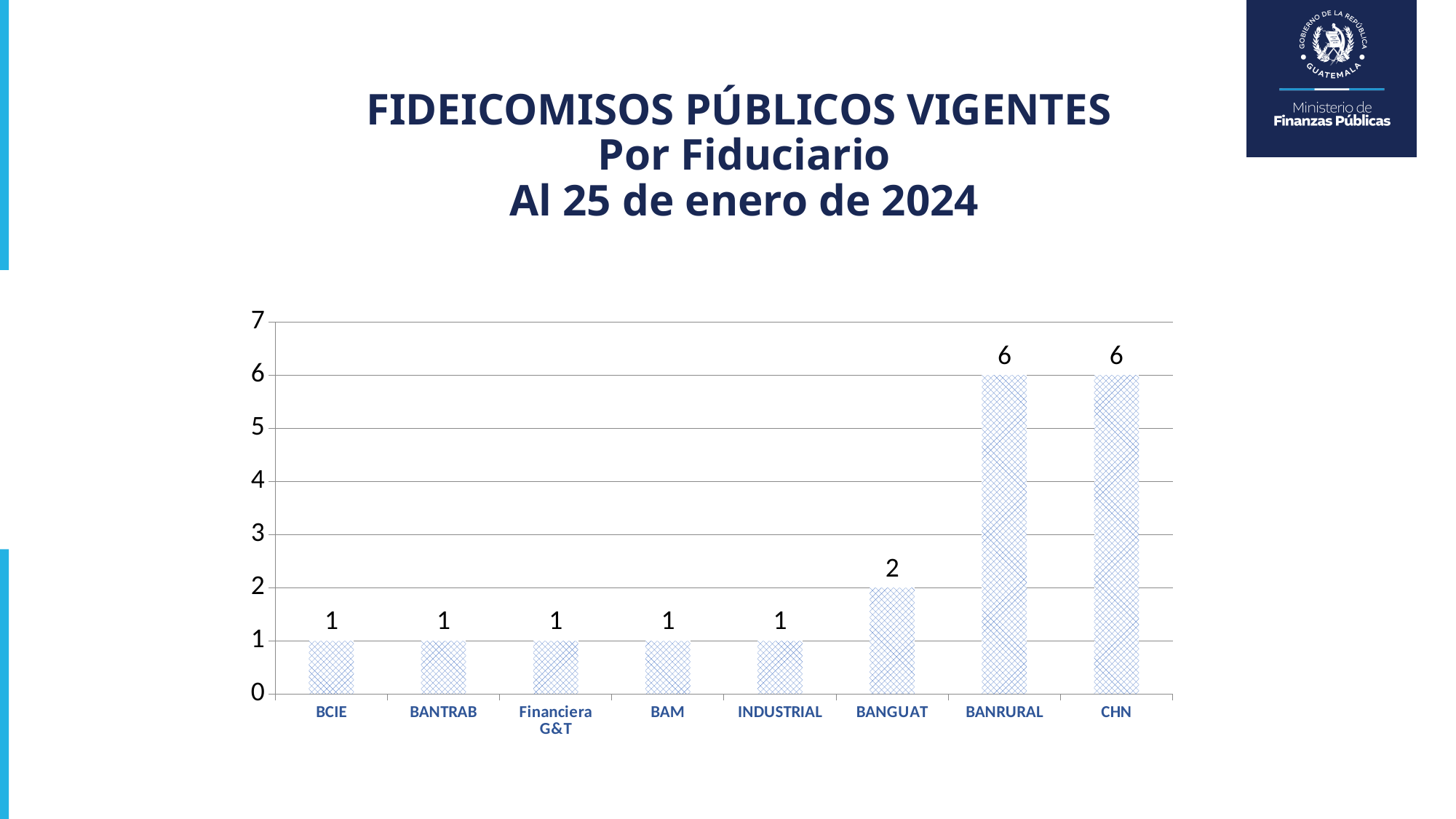
What is the value for BANRURAL? 6 What is the value for BANGUAT? 2 How many categories are shown on the x axis? 8 What is the value for Financiera G&T? 1 What kind of chart is shown on the slide? bar chart What is the difference between the values for BANRURAL and INDUSTRIAL? 5 Which category has the lowest value that is not tied with others, i.e. which category has the value 2? BANGUAT What is the title of the chart on the slide? FIDEICOMISOS PÚBLICOS VIGENTES Por Fiduciario Al 25 de enero de 2024 Which is larger, the value for BANGUAT or the value for BAM? BANGUAT What is the difference between the values for CHN and BANGUAT? 4 Is the value for BANRURAL greater or less than 4? greater What is the value for BCIE? 1